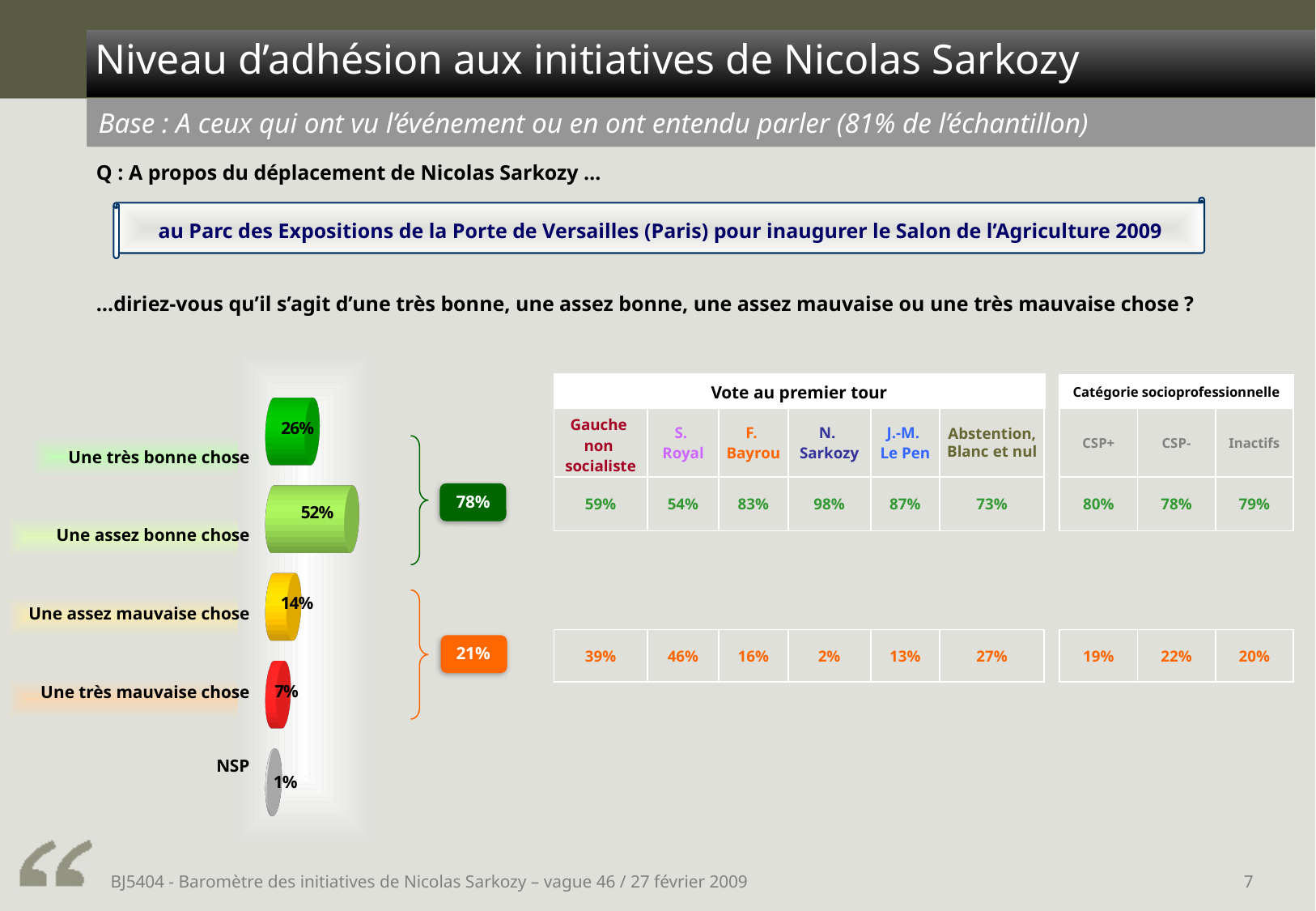
What is the combined percentage shown for the two positive responses (très bonne + assez bonne)? 78% What percentage of respondents said the visit was "Une assez bonne chose"? 52% What is the difference between "Une assez bonne chose" and "Une très bonne chose"? 26% What type of chart is used to display the response percentages? Bar chart Which response category has the highest percentage? Une assez bonne chose What percentage of respondents said the visit was "Une très bonne chose"? 26% What is the combined percentage shown for the two negative responses (assez mauvaise + très mauvaise)? 21% Which response category has the lowest percentage? NSP What percentage of respondents answered "Une très mauvaise chose"? 7% Which is larger: "Une assez mauvaise chose" or "Une très mauvaise chose"? Une assez mauvaise chose What percentage of respondents answered NSP? 1% How many response categories are shown in the chart? 5